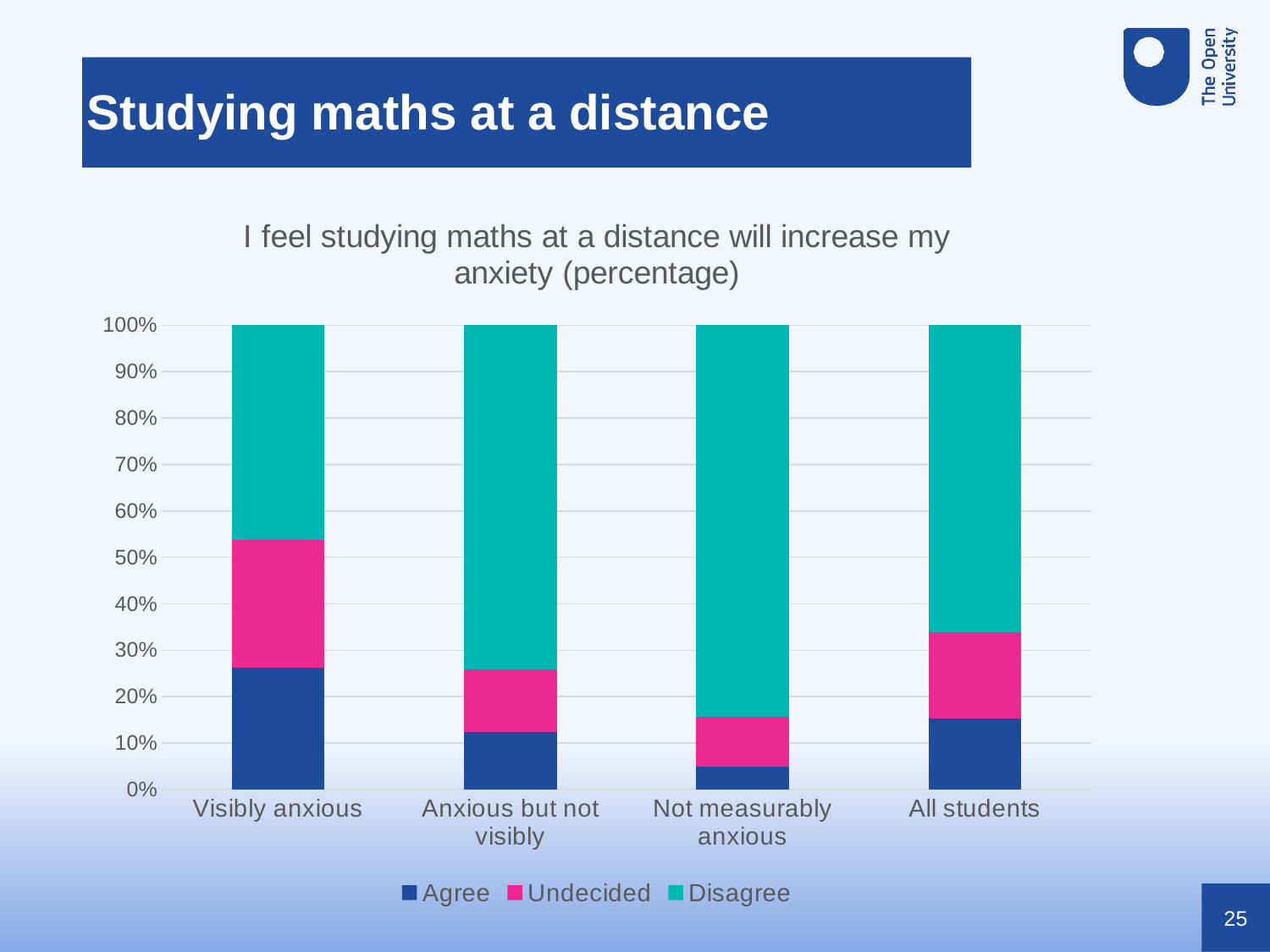
Is the Agree value for Not measurably anxious greater or less than 10%? less Is the Disagree value for Not measurably anxious greater or less than 80%? greater Which category has the smallest Agree share? Not measurably anxious How many series does the chart's legend list? 3 Is the Agree value for Visibly anxious greater or less than 20%? greater What kind of chart is shown on the slide? Stacked bar chart Which category has the largest Agree share? Visibly anxious What are the three series listed in the chart's legend? Agree, Undecided, Disagree Which has the larger Agree share, Visibly anxious or Anxious but not visibly? Visibly anxious How many categories are shown along the x axis of the chart? 4 Which category has the largest Disagree share? Not measurably anxious What is the title of the chart? I feel studying maths at a distance will increase my anxiety (percentage)